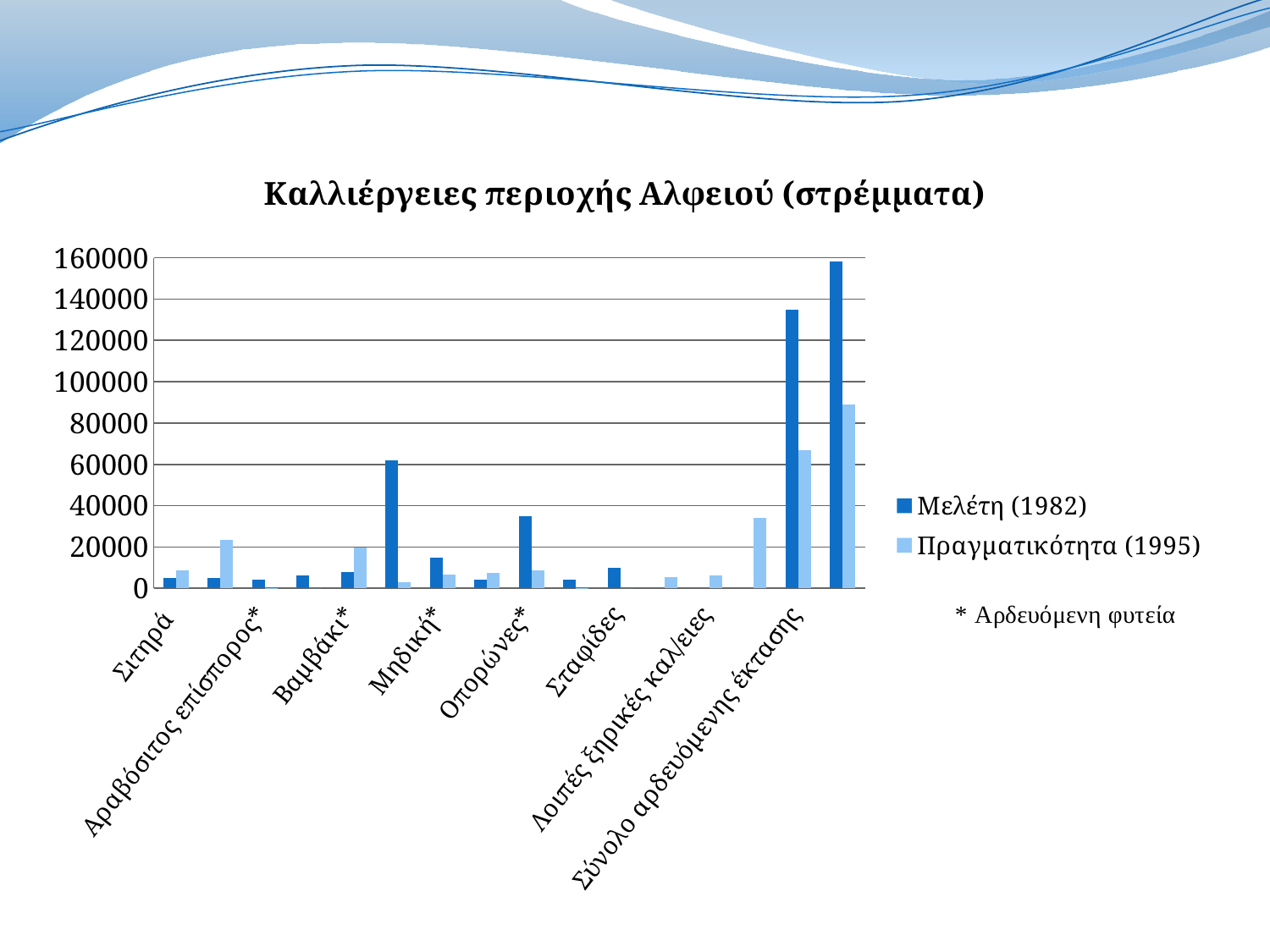
What kind of chart is shown on the slide? Bar chart How many series does the legend list? 2 For Σύνολο αρδευόμενης έκτασης, which series has the larger value, Μελέτη (1982) or Πραγματικότητα (1995)? Μελέτη (1982) What are the two series named in the legend? Μελέτη (1982) and Πραγματικότητα (1995) For Βαμβάκι*, which series has the larger value, Μελέτη (1982) or Πραγματικότητα (1995)? Πραγματικότητα (1995) Is the Μελέτη (1982) value for Σύνολο αρδευόμενης έκτασης greater or less than 120000? greater Is the Μελέτη (1982) value for Σιτηρά greater or less than 20000? less For Οπορώνες*, which series has the larger value, Μελέτη (1982) or Πραγματικότητα (1995)? Μελέτη (1982) Is the Πραγματικότητα (1995) value for Σύνολο αρδευόμενης έκτασης greater or less than 80000? less What is the title of the chart? Καλλιέργειες περιοχής Αλφειού (στρέμματα)